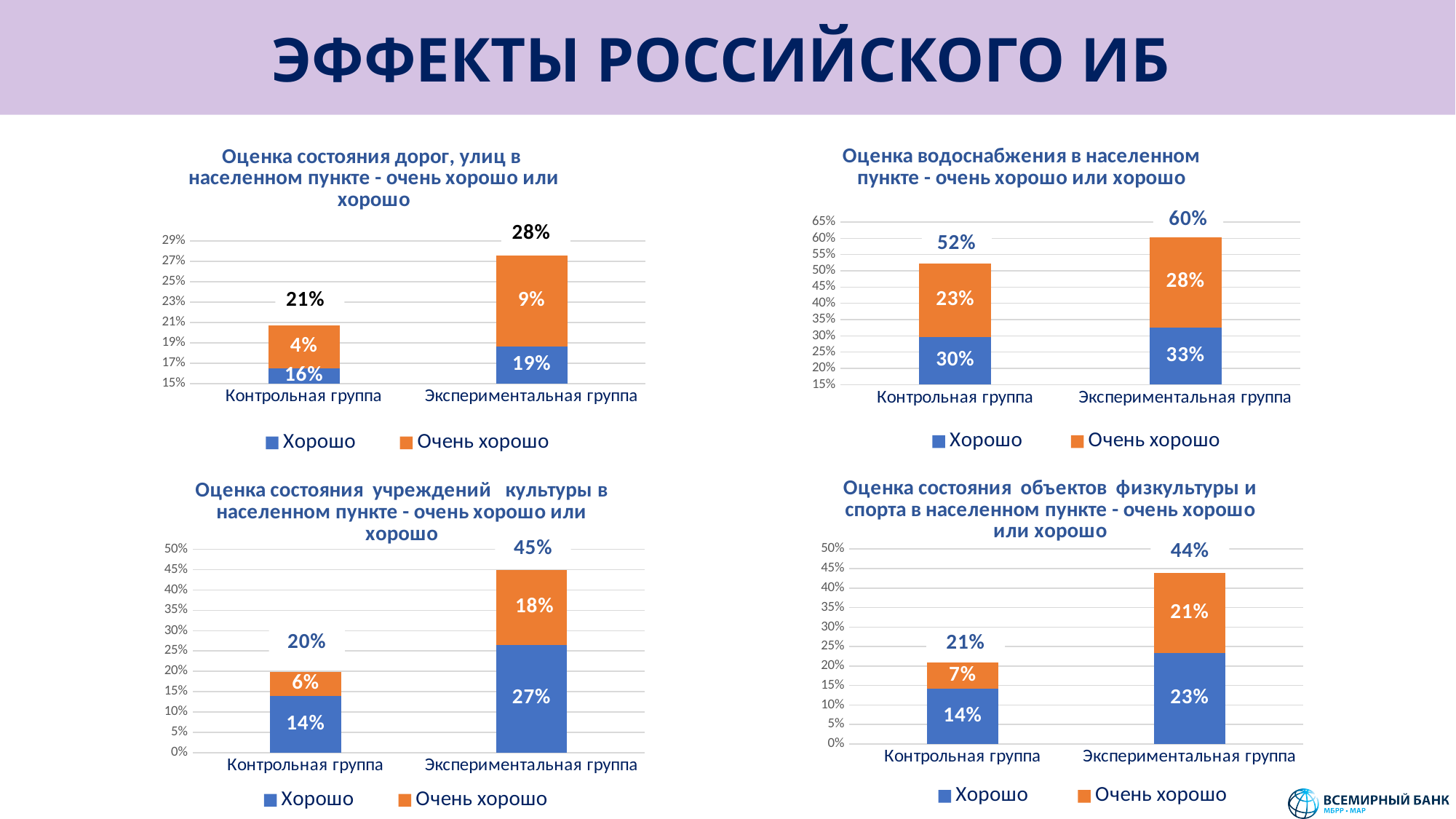
In the top-left chart (Оценка состояния дорог, улиц), what is the 'Хорошо' value for Контрольная группа? 16% In the bottom-left chart (Оценка состояния учреждений культуры), what is the 'Хорошо' value for Экспериментальная группа? 27% What type of chart is the bottom-left chart (Оценка состояния учреждений культуры)? stacked bar chart In the top-right chart (Оценка водоснабжения), what is the 'Очень хорошо' value for Экспериментальная группа? 28% In the bottom-left chart (Оценка состояния учреждений культуры), which group has the higher total? Экспериментальная группа In the bottom-right chart (Оценка состояния объектов физкультуры и спорта), is the total for Контрольная группа greater or less than 25%? less How many charts are shown on the slide? 4 In the top-left chart (Оценка состояния дорог, улиц), what is the total labelled above the Экспериментальная группа bar? 28% In the top-right chart (Оценка водоснабжения), what is the difference between the totals labelled for Экспериментальная группа and Контрольная группа? 8% In the bottom-right chart (Оценка состояния объектов физкультуры и спорта), what is the 'Очень хорошо' value for Контрольная группа? 7% How many series does the legend of the top-right chart (Оценка водоснабжения) list? 2 In the bottom-right chart (Оценка состояния объектов физкультуры и спорта), what is the total labelled above the Экспериментальная группа bar? 44%